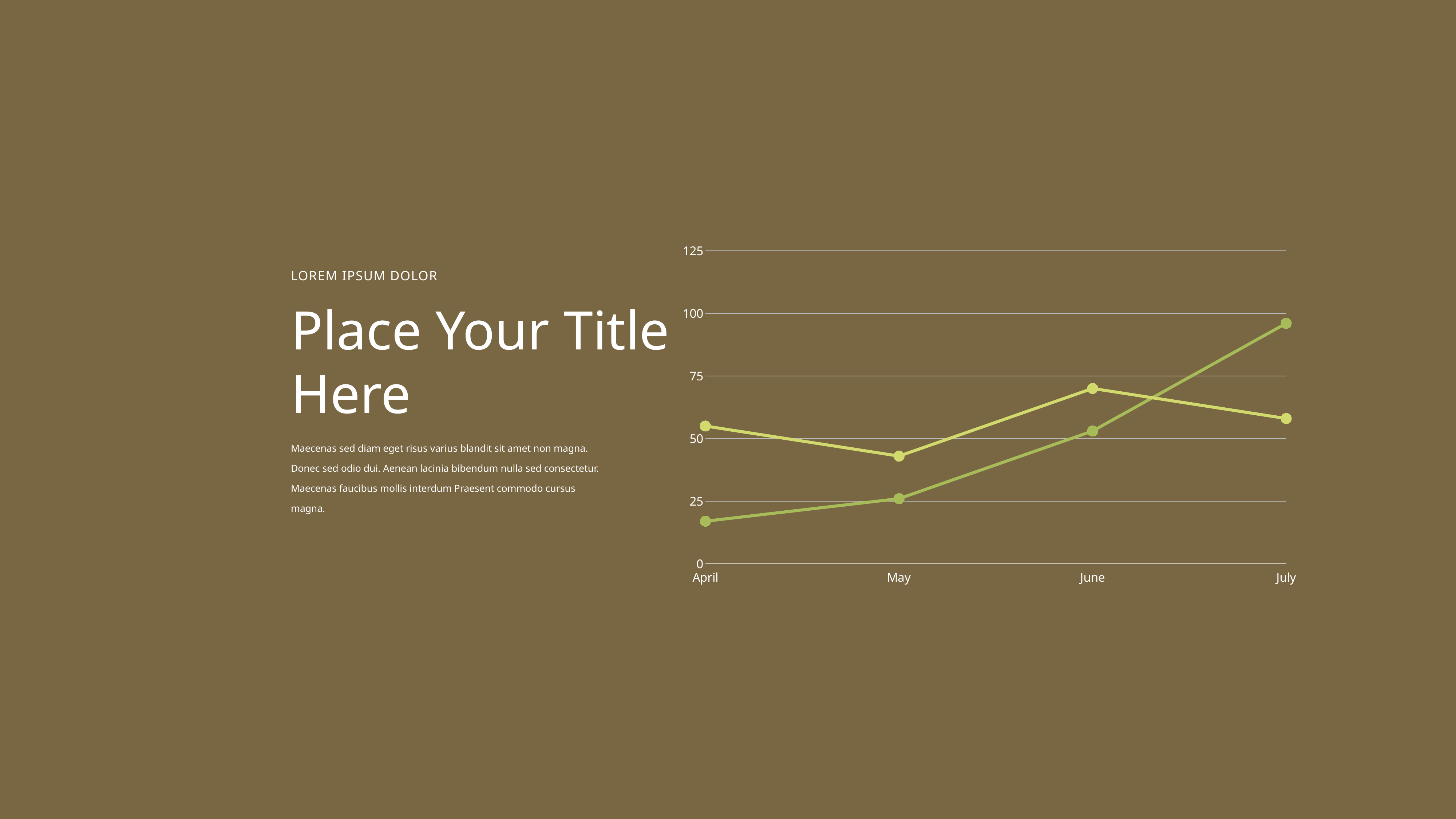
For the line that is highest in April, in which month does it reach its lowest value? May How many lines are plotted on the chart? 2 What kind of chart is shown on the slide? line chart For the line that is lowest in April, is its July value greater or less than 75? greater For the line that is lowest in April, is its April value greater or less than 25? less What is the first month shown on the x axis of the chart? April For the line that is lowest in April, in which month does it reach its highest value? July Does the line that is lowest in April rise or fall from April to July? rise How many months are shown on the x axis of the chart? 4 For the line that is highest in April, is its May value greater or less than 50? less In July, which line is higher: the one that was highest in April or the one that was lowest in April? the one that was lowest in April